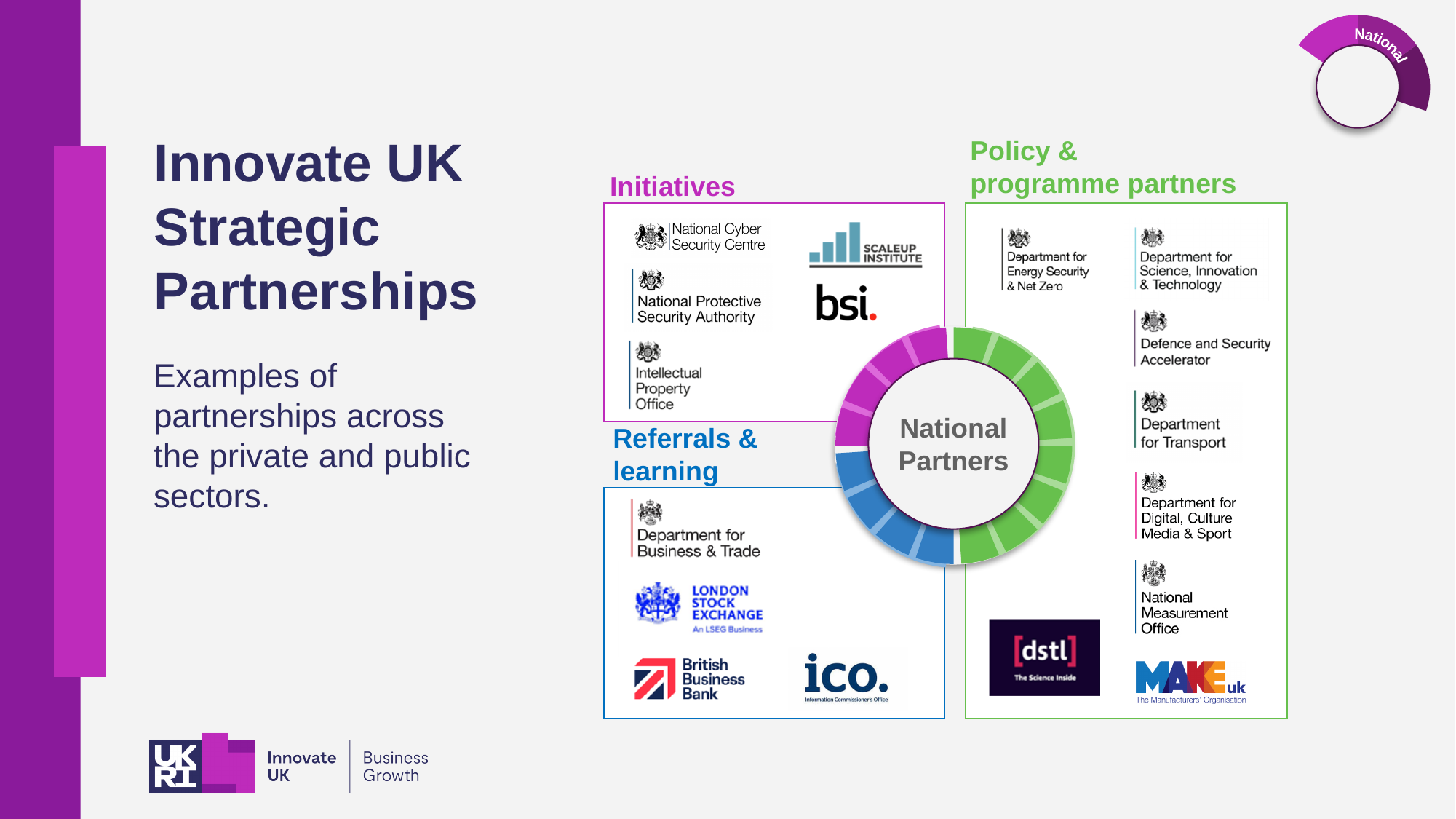
Which colour group takes up the largest share of the donut chart? Green (Policy & programme partners) Is the green share of the donut chart larger or smaller than the purple share? Larger What label appears in the centre of the donut chart? National Partners Is the green share of the donut chart larger or smaller than the blue share? Larger How many colour groups does the donut chart have? 3 Which category does the blue portion of the donut chart correspond to? Referrals & learning What kind of chart is shown in the centre of the slide? Pie chart (donut) Which category does the green portion of the donut chart correspond to? Policy & programme partners